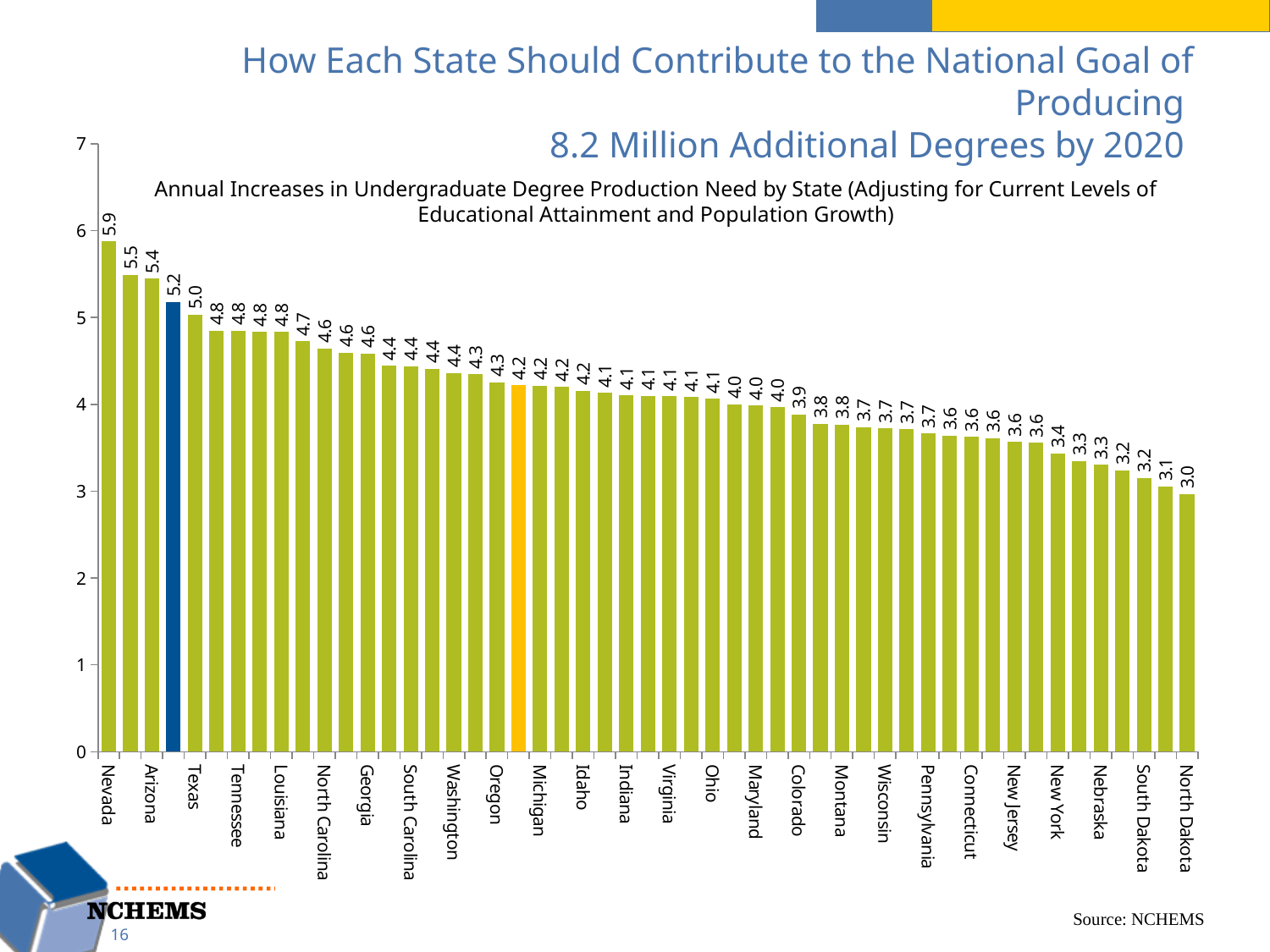
What is the value shown for Arizona? 5.4 Do the values rise or fall moving from left to right along the x axis? fall Is the value for North Dakota greater or less than 4? less Is the value for Nevada greater or less than 5? greater What is the source cited for the chart? NCHEMS What is the value shown for North Dakota? 3.0 Which has a larger value, Nevada or Arizona? Nevada What is the difference between the values for Nevada and North Dakota? 2.9 Which state has the highest value in the chart? Nevada What kind of chart is shown on the slide? bar chart What is the value shown for Nevada? 5.9 Which state has the lowest value in the chart? North Dakota